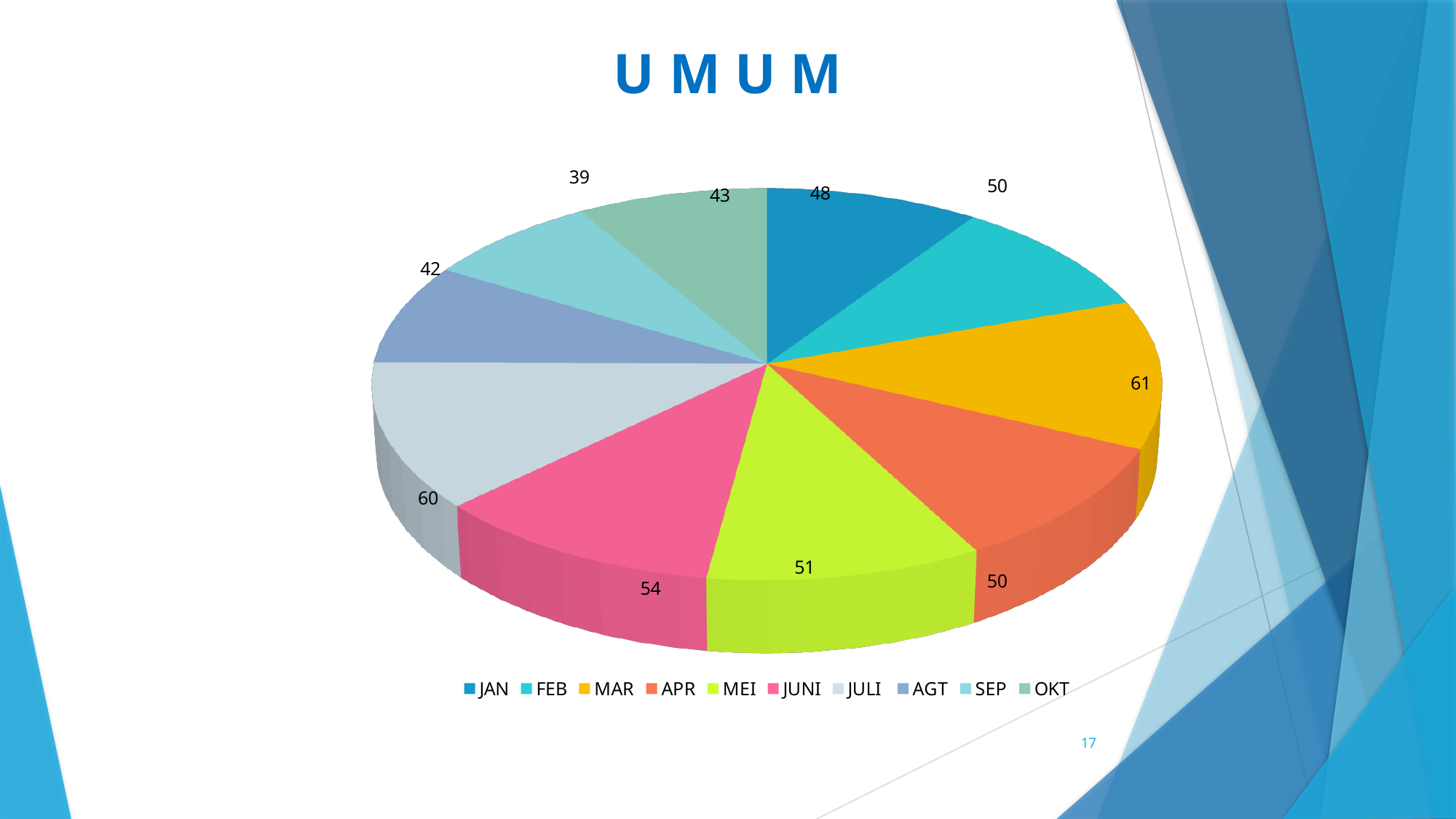
What is the value for JAN? 48 What is the title of the slide? UMUM Which is larger, the value for JUNI or the value for MEI? JUNI Which category has the highest value? MAR What is the value for JULI? 60 What is the difference between the values for MAR and SEP? 22 What is the value for MAR? 61 What kind of chart is shown on the slide? pie chart What is the difference between the values for JULI and AGT? 18 How many slices does the pie chart have? 10 What is the value for SEP? 39 Which category has the lowest value? SEP